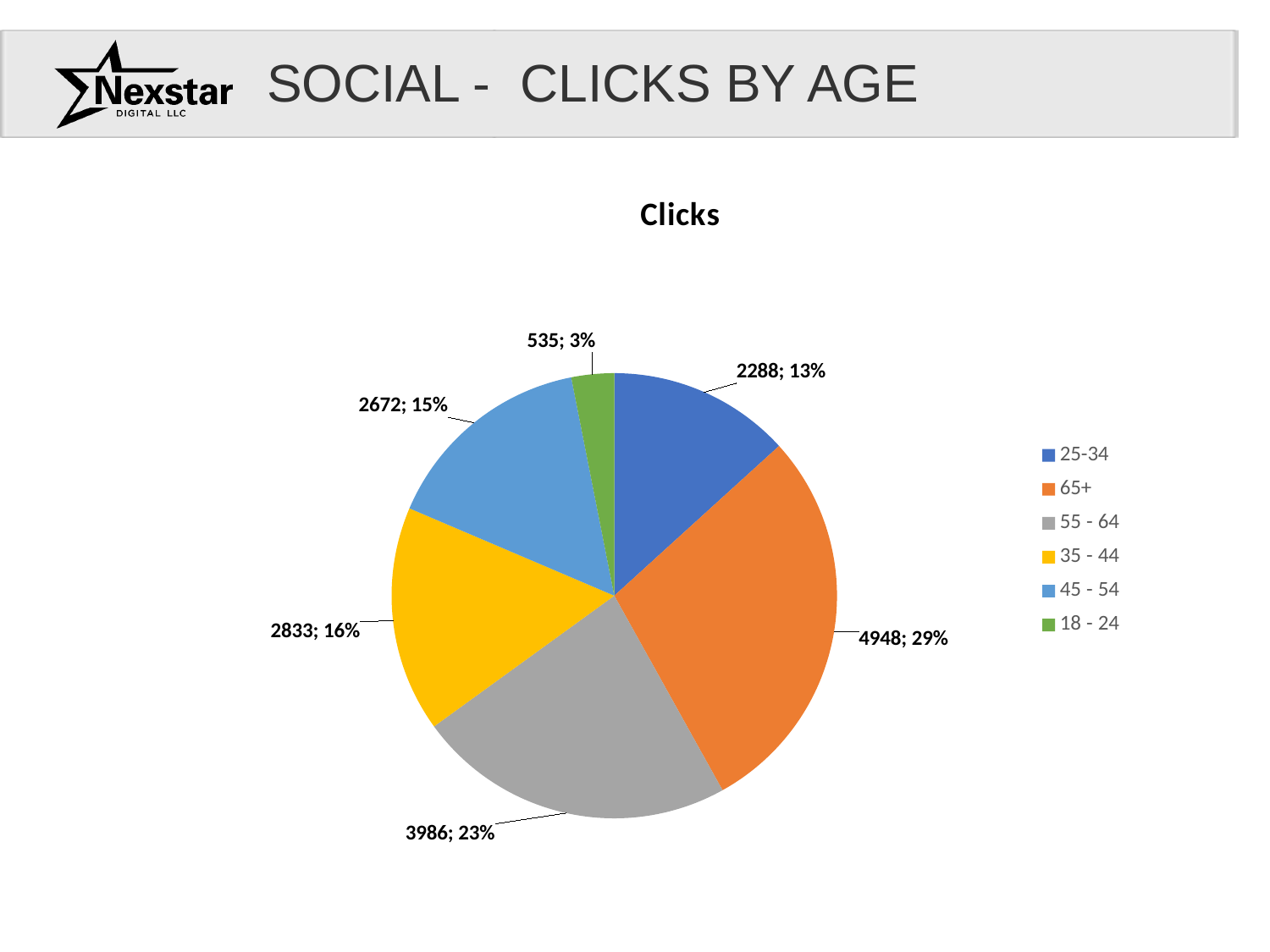
What is the title of the chart? Clicks What share of clicks does the 35 - 44 age group account for? 16% How many clicks are shown for the 18 - 24 age group? 535 What share of clicks does the 55 - 64 age group account for? 23% Which age group has the fewest clicks? 18 - 24 How many clicks are shown for the 65+ age group? 4948 What is the difference in clicks between the 65+ and 55 - 64 age groups? 962 How many age groups does the legend list? 6 Which age group has the most clicks? 65+ What kind of chart is shown on the slide? pie chart How many clicks are shown for the 25-34 age group? 2288 Which age group has more clicks, 45 - 54 or 35 - 44? 35 - 44